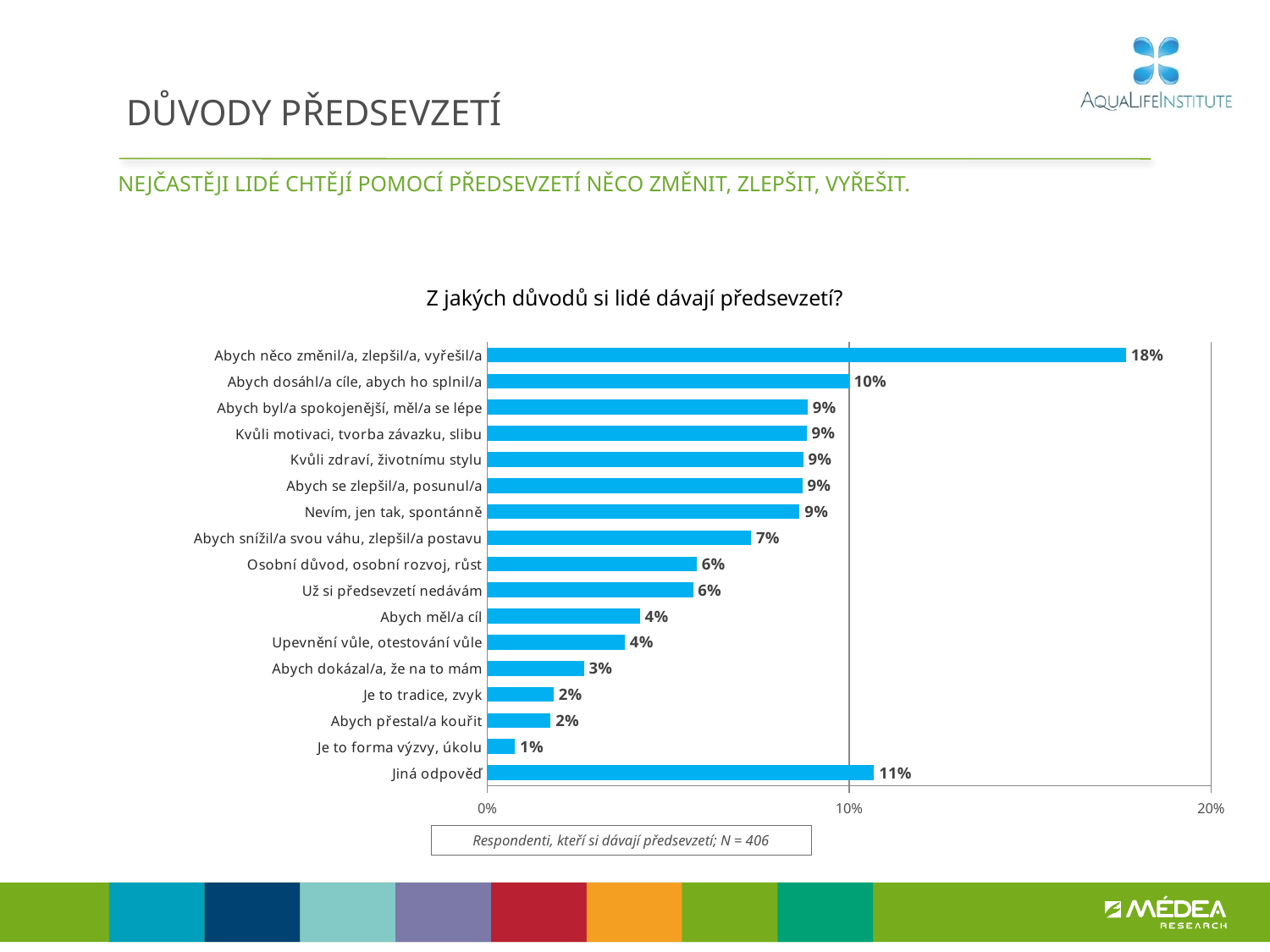
What is the title of the chart? Z jakých důvodů si lidé dávají předsevzetí? Is the value for "Abych něco změnil/a, zlepšil/a, vyřešil/a" greater or less than 10%? greater Which category has the highest value? Abych něco změnil/a, zlepšil/a, vyřešil/a Which category has the lowest value? Je to forma výzvy, úkolu Which is larger: the value for "Jiná odpověď" or the value for "Abych dosáhl/a cíle, abych ho splnil/a"? Jiná odpověď What is the value for "Jiná odpověď"? 11% What is the value for "Abych něco změnil/a, zlepšil/a, vyřešil/a"? 18% How many categories are shown in the chart? 17 What is the value for "Je to forma výzvy, úkolu"? 1% What kind of chart is shown on the slide? bar chart What is the difference between the values for "Abych něco změnil/a, zlepšil/a, vyřešil/a" and "Abych dosáhl/a cíle, abych ho splnil/a"? 8 percentage points What is the value for "Abych snížil/a svou váhu, zlepšil/a postavu"? 7%